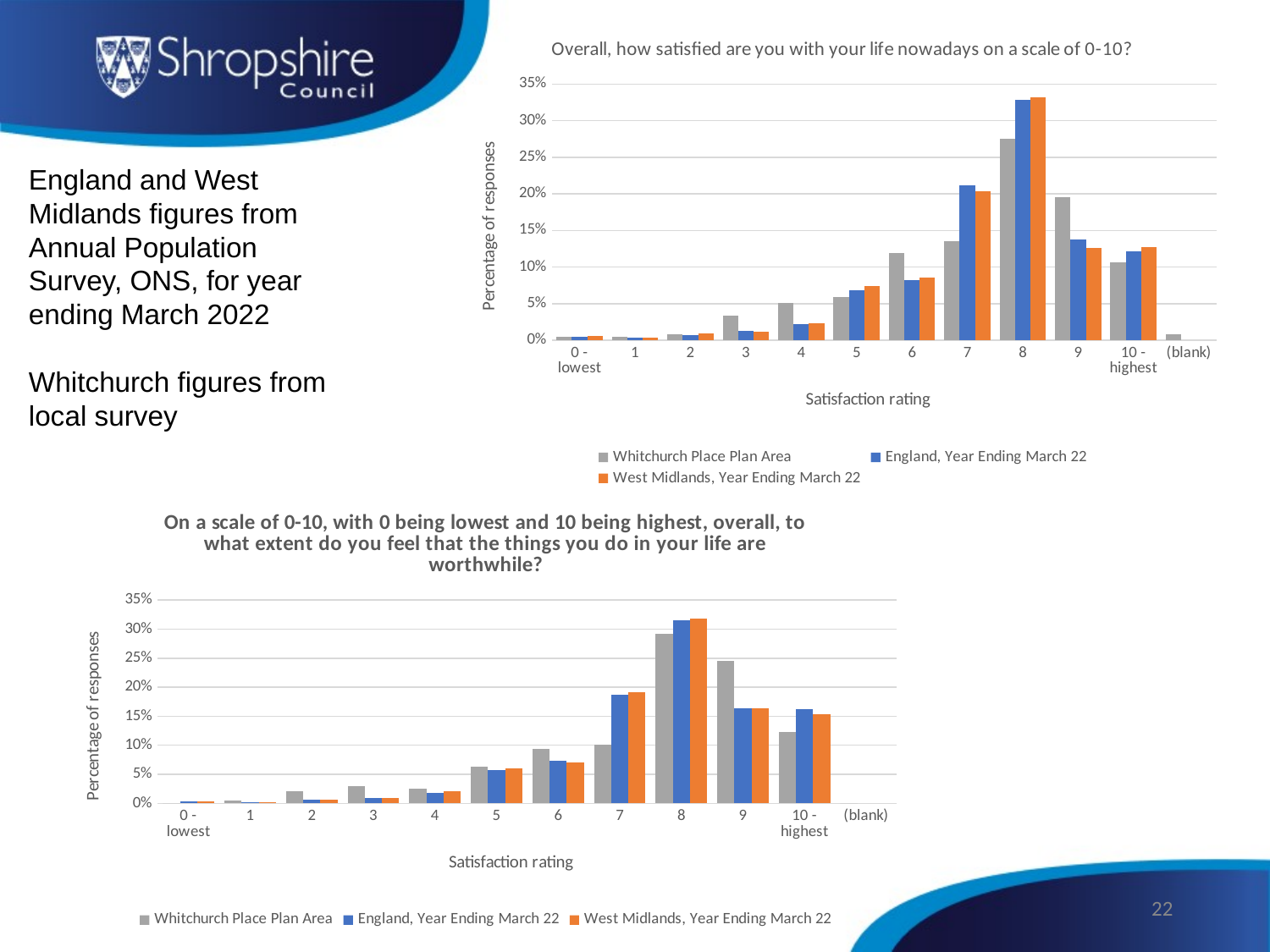
In the top chart (life satisfaction), at rating 7, which is larger: Whitchurch Place Plan Area or England, Year Ending March 22? England, Year Ending March 22 In the bottom chart (worthwhile), is the value for Whitchurch Place Plan Area at rating 9 greater or less than 20%? greater In the top chart (life satisfaction), how many satisfaction rating categories are shown on the x axis? 12 In the bottom chart (worthwhile), at rating 10 - highest, which is larger: Whitchurch Place Plan Area or England, Year Ending March 22? England, Year Ending March 22 In the top chart (life satisfaction), is the value for Whitchurch Place Plan Area at rating 8 greater or less than 30%? less In the top chart (life satisfaction), at rating 9, which is larger: Whitchurch Place Plan Area or England, Year Ending March 22? Whitchurch Place Plan Area In the top chart (life satisfaction), what kind of chart is shown? bar chart In the bottom chart (worthwhile), do the values for England, Year Ending March 22 rise or fall from rating 0 to rating 8? rise In the top chart (life satisfaction), how many series does the legend list? 3 In the top chart (life satisfaction), which satisfaction rating has the highest value for England, Year Ending March 22? 8 In the top chart (life satisfaction), is the value for England, Year Ending March 22 at rating 8 greater or less than 30%? greater In the bottom chart (worthwhile), which satisfaction rating has the highest value for Whitchurch Place Plan Area? 8